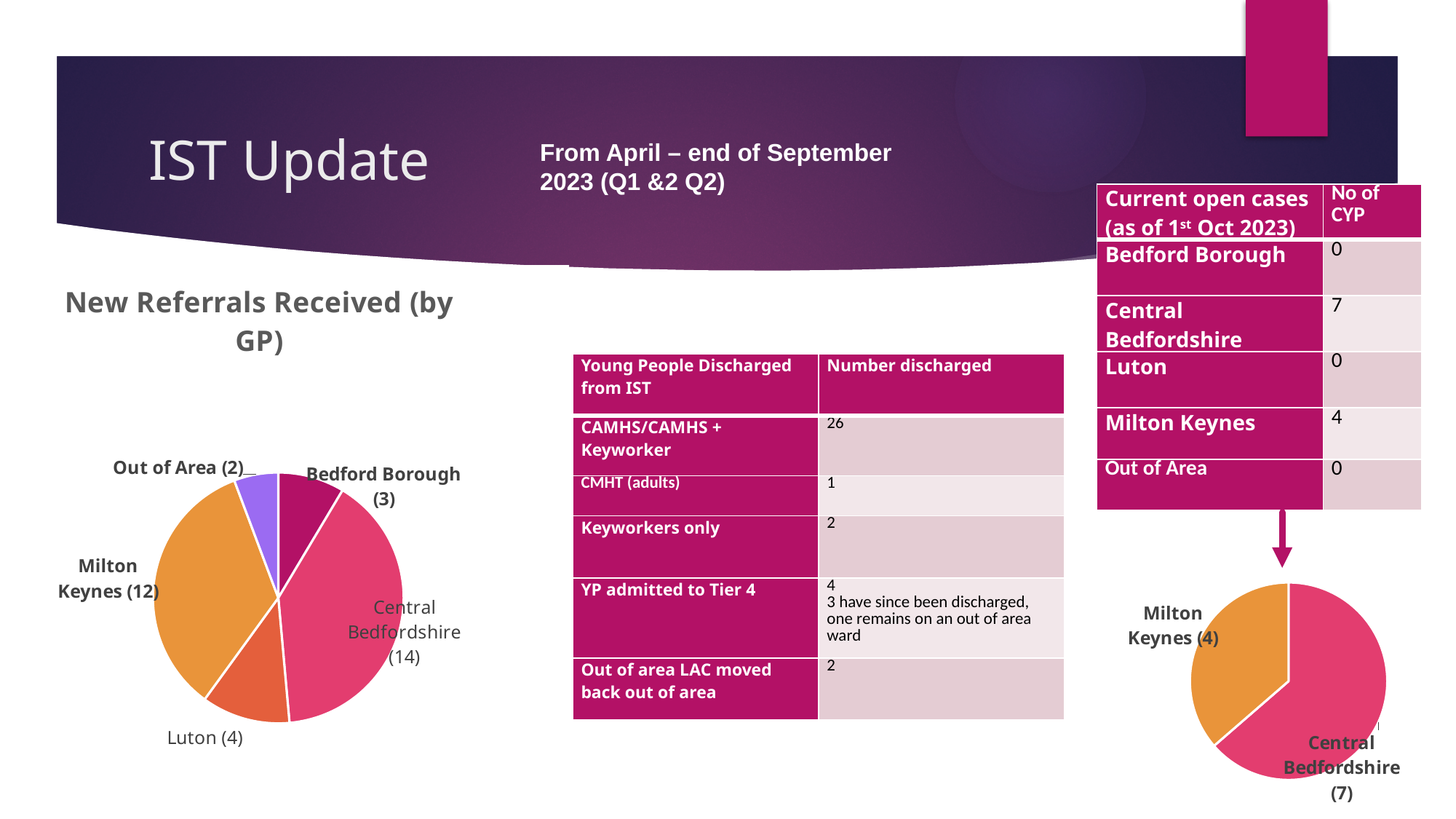
In the 'New Referrals Received (by GP)' chart, which area has the highest number of referrals? Central Bedfordshire In the pie chart at the bottom right of the slide, which area has the larger slice, Milton Keynes or Central Bedfordshire? Central Bedfordshire In the 'New Referrals Received (by GP)' chart, which area has the lowest number of referrals? Out of Area In the 'New Referrals Received (by GP)' chart, how many areas (slices) are shown? 5 In the 'New Referrals Received (by GP)' chart, what kind of chart is shown? Pie chart In the 'New Referrals Received (by GP)' chart, how many referrals were received from Milton Keynes? 12 In the 'New Referrals Received (by GP)' chart, how many referrals were received from Central Bedfordshire? 14 In the pie chart at the bottom right of the slide, how many cases are shown for Central Bedfordshire? 7 In the pie chart at the bottom right of the slide, how many slices are there? 2 In the 'New Referrals Received (by GP)' chart, what share of all referrals came from Central Bedfordshire? 40% In the 'New Referrals Received (by GP)' chart, which has more referrals, Bedford Borough or Luton? Luton In the 'New Referrals Received (by GP)' chart, what is the difference between the referrals from Central Bedfordshire and Luton? 10